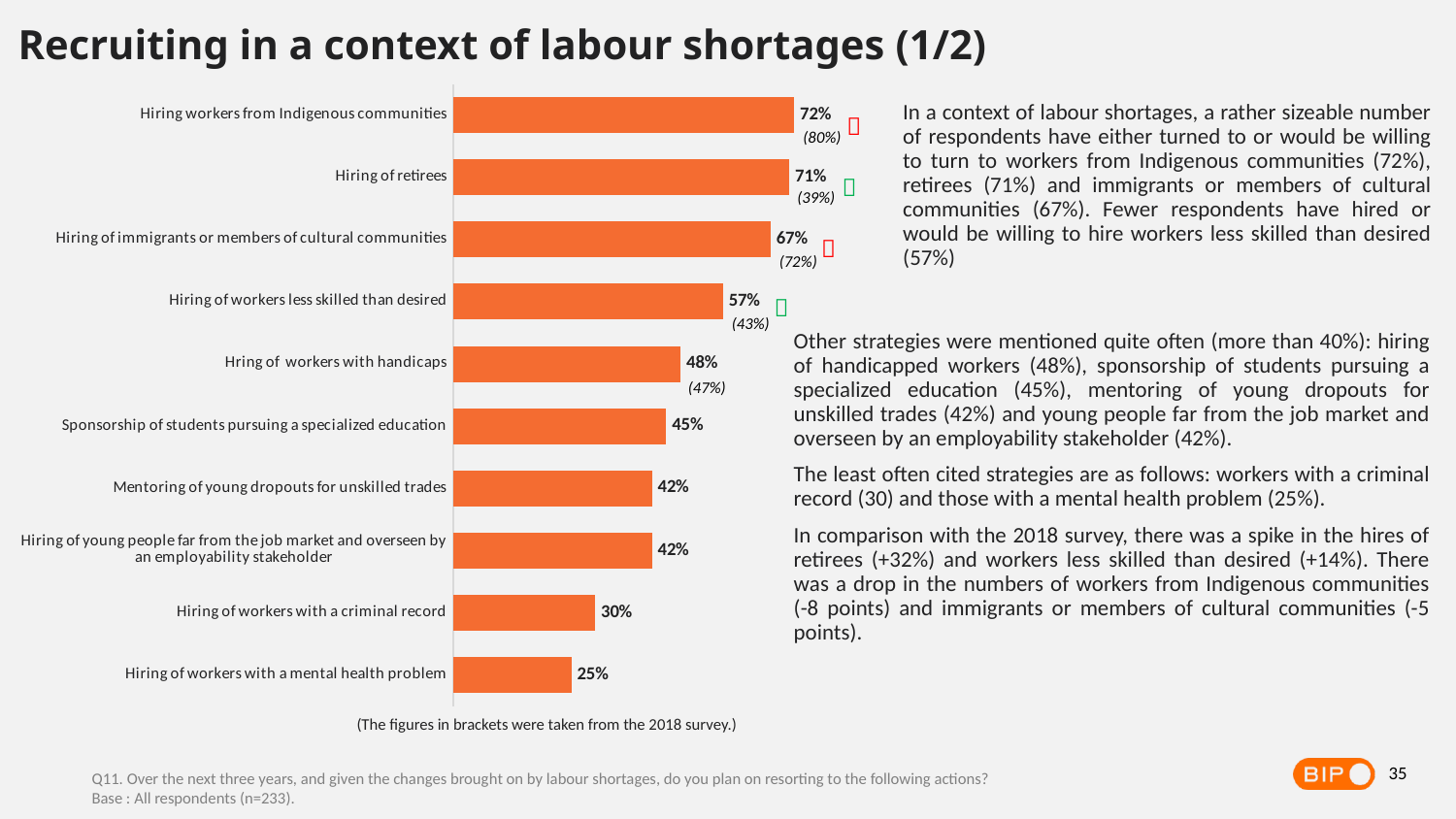
What is the value for 'Sponsorship of students pursuing a specialized education'? 45% What colour are the bars in the chart? Orange What is the difference between the values for 'Hiring of retirees' and 'Hiring of workers less skilled than desired'? 14% How many categories are shown in the chart? 10 What is the difference between the 2018 figure and the current figure for 'Hiring workers from Indigenous communities'? 8% What was the 2018 survey figure shown in brackets for 'Hiring of retirees'? 39% Which category has the lowest value? Hiring of workers with a mental health problem What is the value for 'Hiring of workers with a criminal record'? 30% Which category has the highest value? Hiring workers from Indigenous communities What kind of chart is shown on the slide? Bar chart What is the value for 'Hiring workers from Indigenous communities'? 72% Which is larger: the value for 'Hring of workers with handicaps' or for 'Hiring of workers with a criminal record'? Hring of workers with handicaps